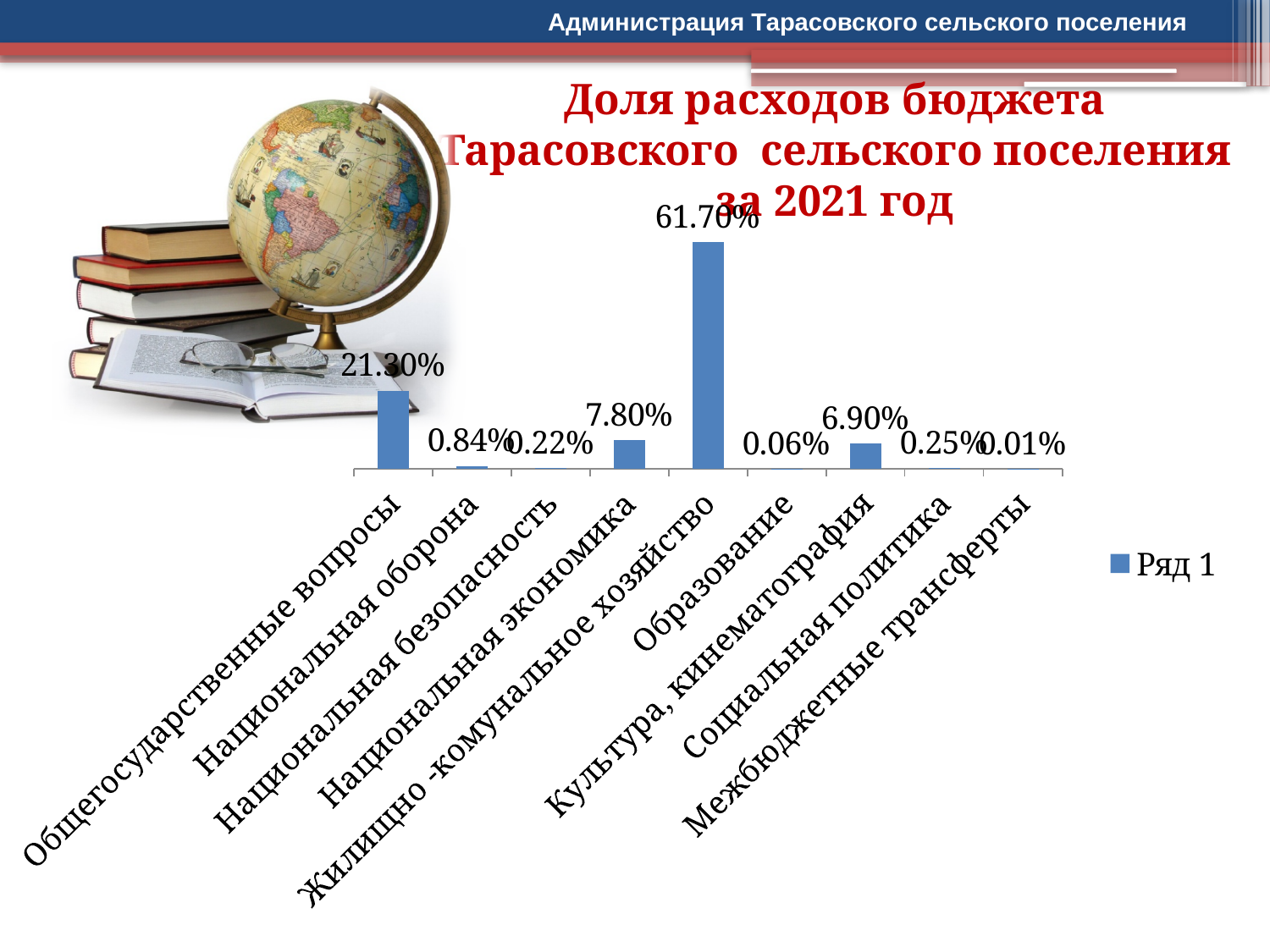
Which category has the highest value? Жилищно-коммунальное хозяйство Which category has the lowest value? Межбюджетные трансферты How many categories are shown on the x axis? 9 Which is larger, the value for Национальная безопасность or the value for Национальная оборона? Национальная оборона What is the value for Образование? 0.06% What is the difference between the values for Национальная экономика and Культура, кинематография? 0.90% What is the value for Жилищно-коммунальное хозяйство? 61.70% What is the value for Культура, кинематография? 6.90% What is the value for Национальная экономика? 7.80% What kind of chart is shown on the slide? Bar chart What is the value for Социальная политика? 0.25% What is the value for Национальная оборона? 0.84%